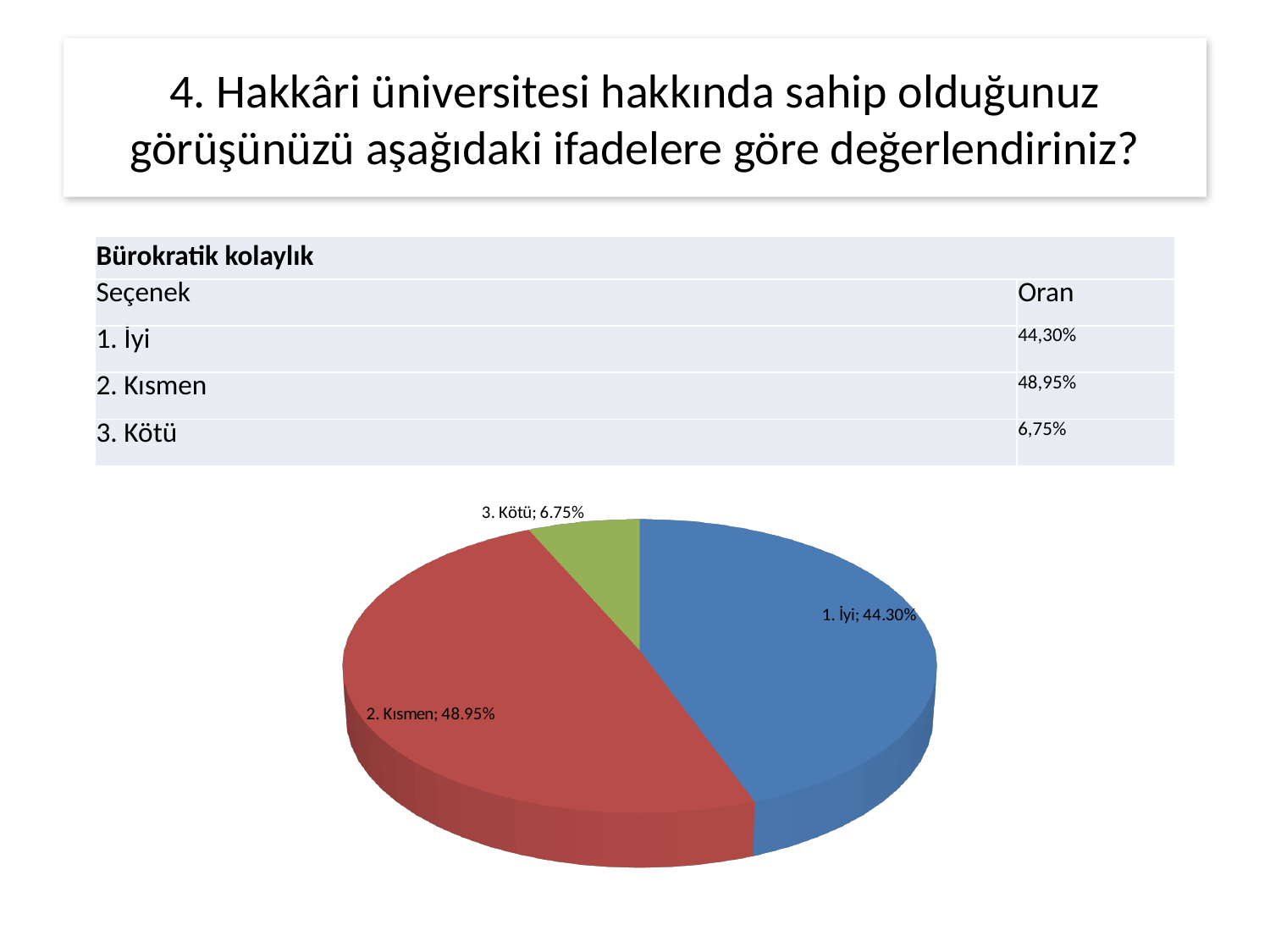
What is the value shown for the "3. Kötü" slice in the pie chart? 6.75% What share of the pie does the "2. Kısmen" slice represent? 48.95% What is the difference between the "1. İyi" and "3. Kötü" values in the pie chart? 37.55% Which slice of the pie chart has the smallest value? 3. Kötü What is the value shown for the "2. Kısmen" slice in the pie chart? 48.95% What kind of chart is shown on the slide? Pie chart Which slice of the pie chart has the largest value? 2. Kısmen What colour is the "3. Kötü" slice in the pie chart? Green What is the value shown for the "1. İyi" slice in the pie chart? 44.30% In the pie chart, which is larger: "1. İyi" or "3. Kötü"? 1. İyi How many slices does the pie chart have? 3 What is the difference between the "2. Kısmen" and "1. İyi" values in the pie chart? 4.65%